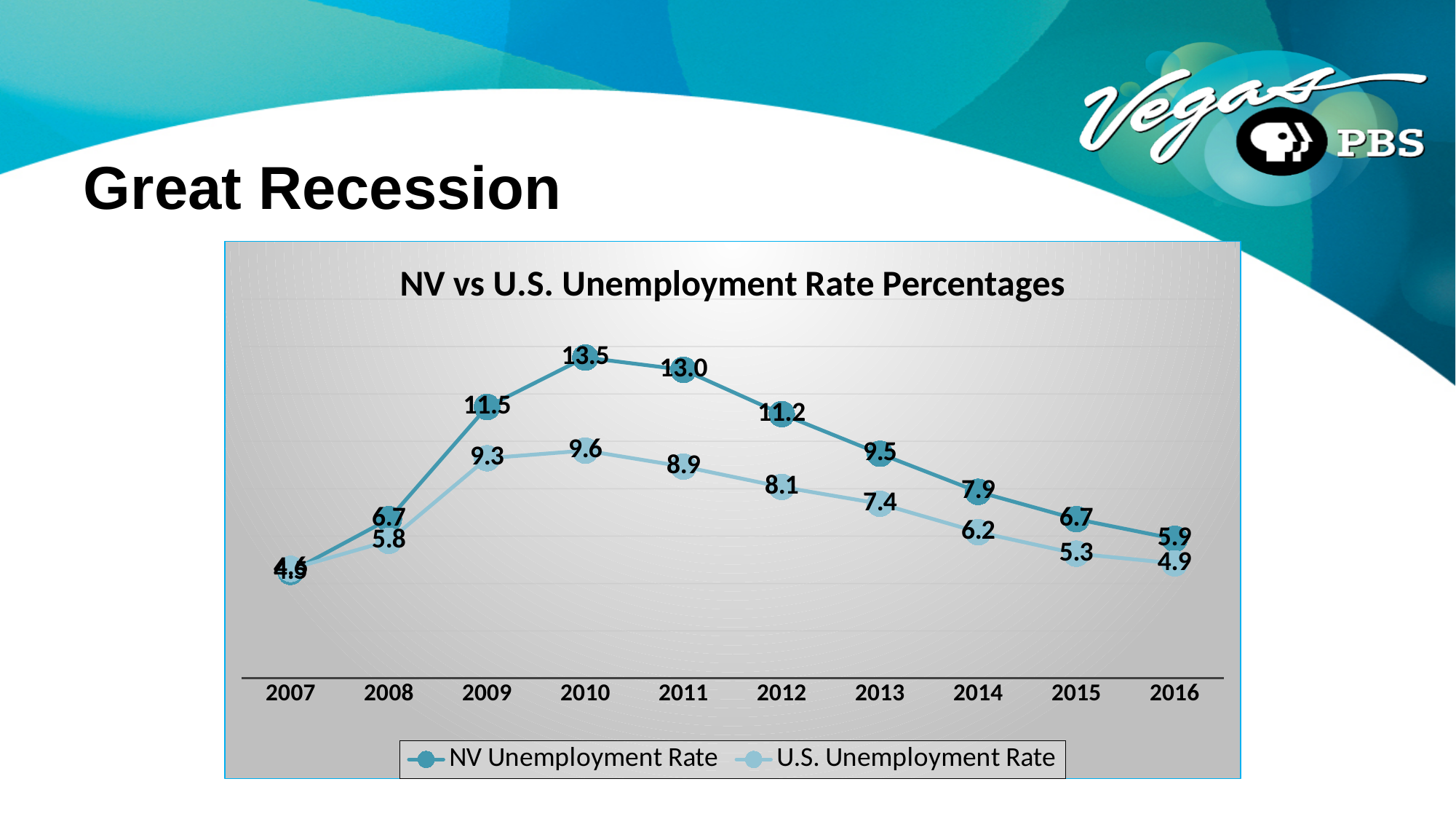
In which year is the NV Unemployment Rate highest? 2010 What is the U.S. Unemployment Rate in 2009? 9.3 What type of chart is shown on the slide? line chart Which is larger in 2014, the NV Unemployment Rate or the U.S. Unemployment Rate? NV Unemployment Rate How many series does the legend list? 2 In which year is the U.S. Unemployment Rate highest? 2010 What is the difference between the NV and U.S. Unemployment Rates in 2011? 4.1 How many years are shown on the x axis? 10 What is the U.S. Unemployment Rate in 2012? 8.1 What is the NV Unemployment Rate in 2016? 5.9 What is the NV Unemployment Rate in 2010? 13.5 Does the NV Unemployment Rate rise or fall from 2010 to 2016? fall